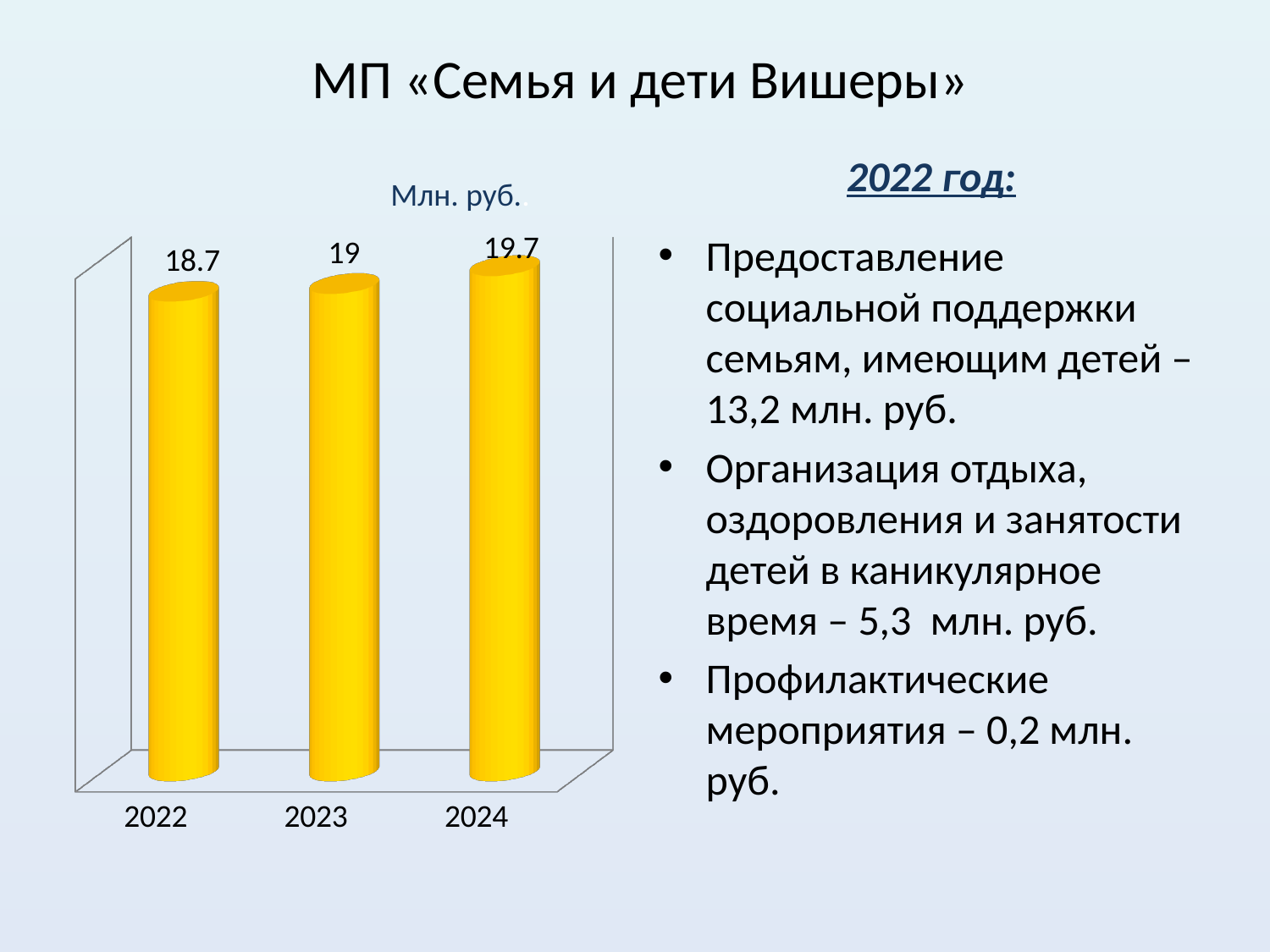
Do the values rise or fall from 2022 to 2024? rise Which year has the lowest value in the chart? 2022 What is the difference between the values for 2024 and 2022? 1 What is the value for 2023 in the chart? 19 What is the value for 2022 in the chart? 18.7 What kind of chart is shown on the slide? bar chart What is the value for 2024 in the chart? 19.7 What is the difference between the values for 2023 and 2022? 0.3 What is the title of the chart? Млн. руб. Which year has the highest value in the chart? 2024 How many years are shown in the chart? 3 Which is larger, the value for 2024 or the value for 2023? 2024